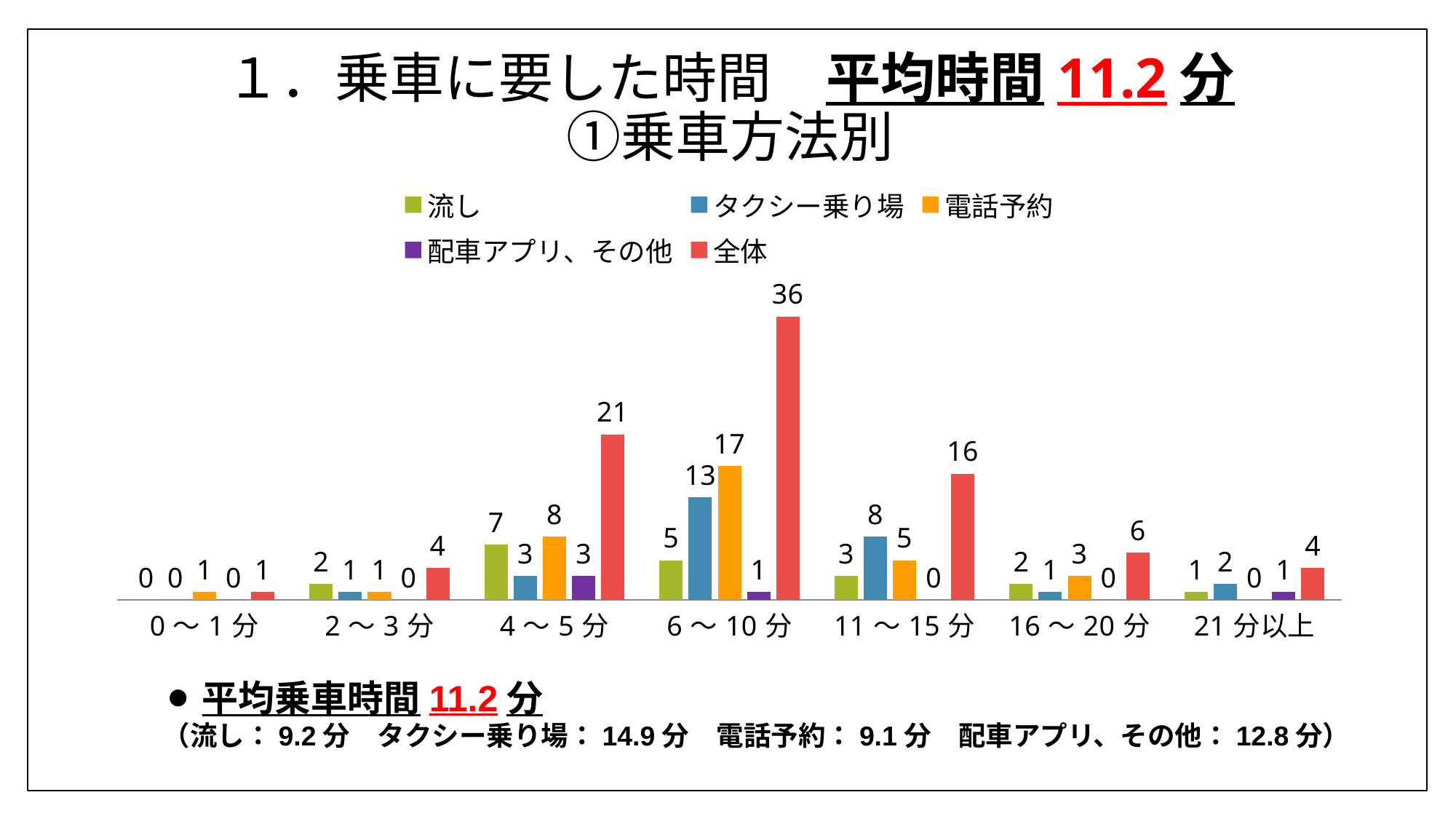
In the 6～10分 category, which is larger: タクシー乗り場 or 電話予約? 電話予約 Which category has the lowest value for 全体? 0～1分 What is the value of 電話予約 for the 4～5分 category? 8 What is the difference between the 全体 values for 6～10分 and 4～5分? 15 How many series does the legend list? 5 What is the value of 全体 for the 6～10分 category? 36 Which category has the highest value for 全体? 6～10分 What type of chart is shown on the slide? bar chart Which series is shown in red in the legend? 全体 What is the value of タクシー乗り場 for the 11～15分 category? 8 How many time categories are shown on the x axis? 7 What is the difference between 流し and 配車アプリ、その他 in the 4～5分 category? 4